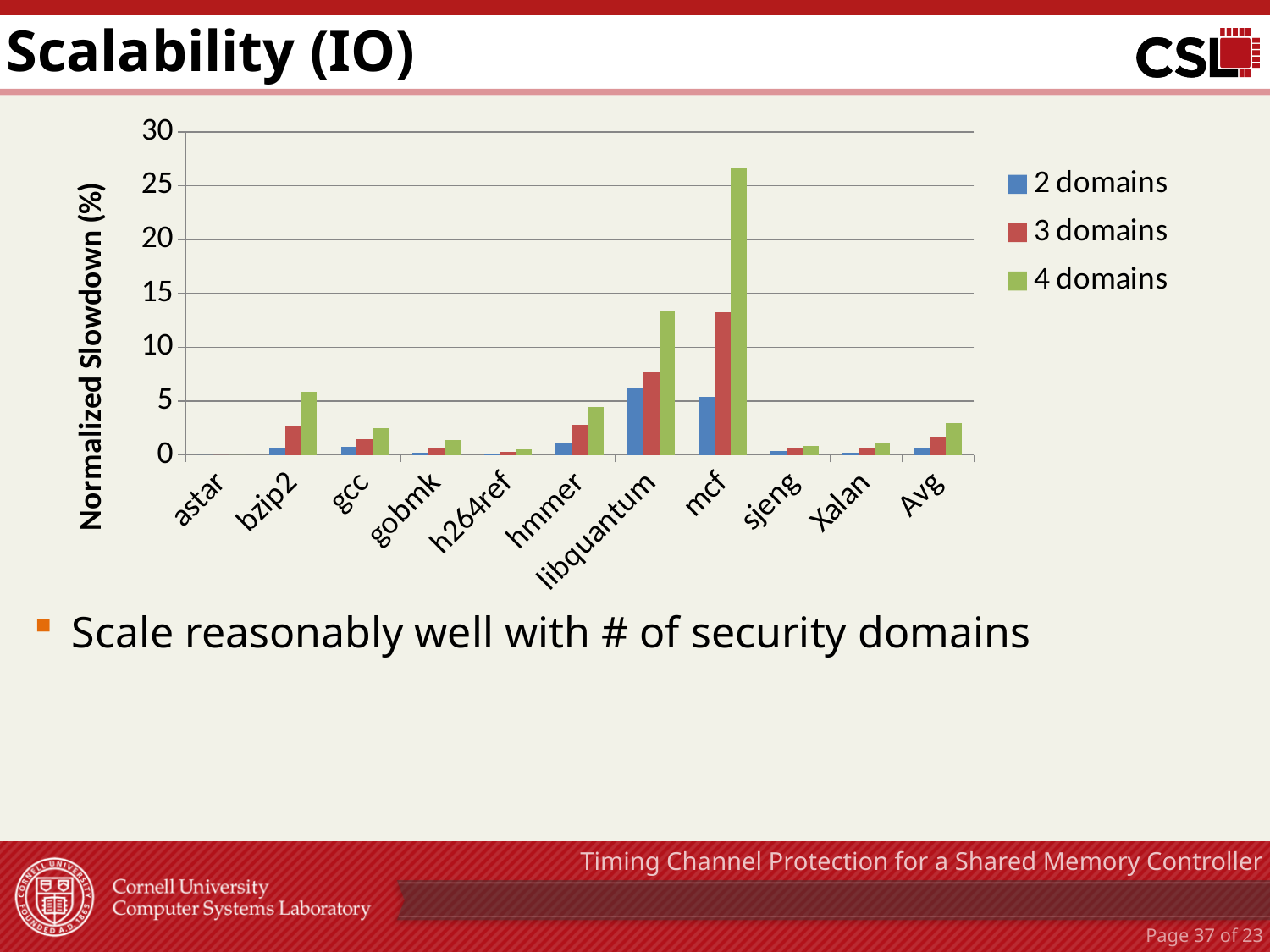
Which is larger for the 4 domains series: bzip2 or gcc? bzip2 What is the label of the y axis of the chart? Normalized Slowdown (%) How many series does the chart's legend list? 3 Is the 4 domains value for mcf greater or less than 25? greater Which series is shown in green in the chart? 4 domains Is the 4 domains value for bzip2 greater or less than 10? less Which is larger for the 4 domains series: libquantum or mcf? mcf How many categories are shown along the x axis of the chart? 11 Is the 4 domains value for libquantum greater or less than 10? greater Which category has the highest value for the 4 domains series? mcf What kind of chart is shown on the slide? bar chart